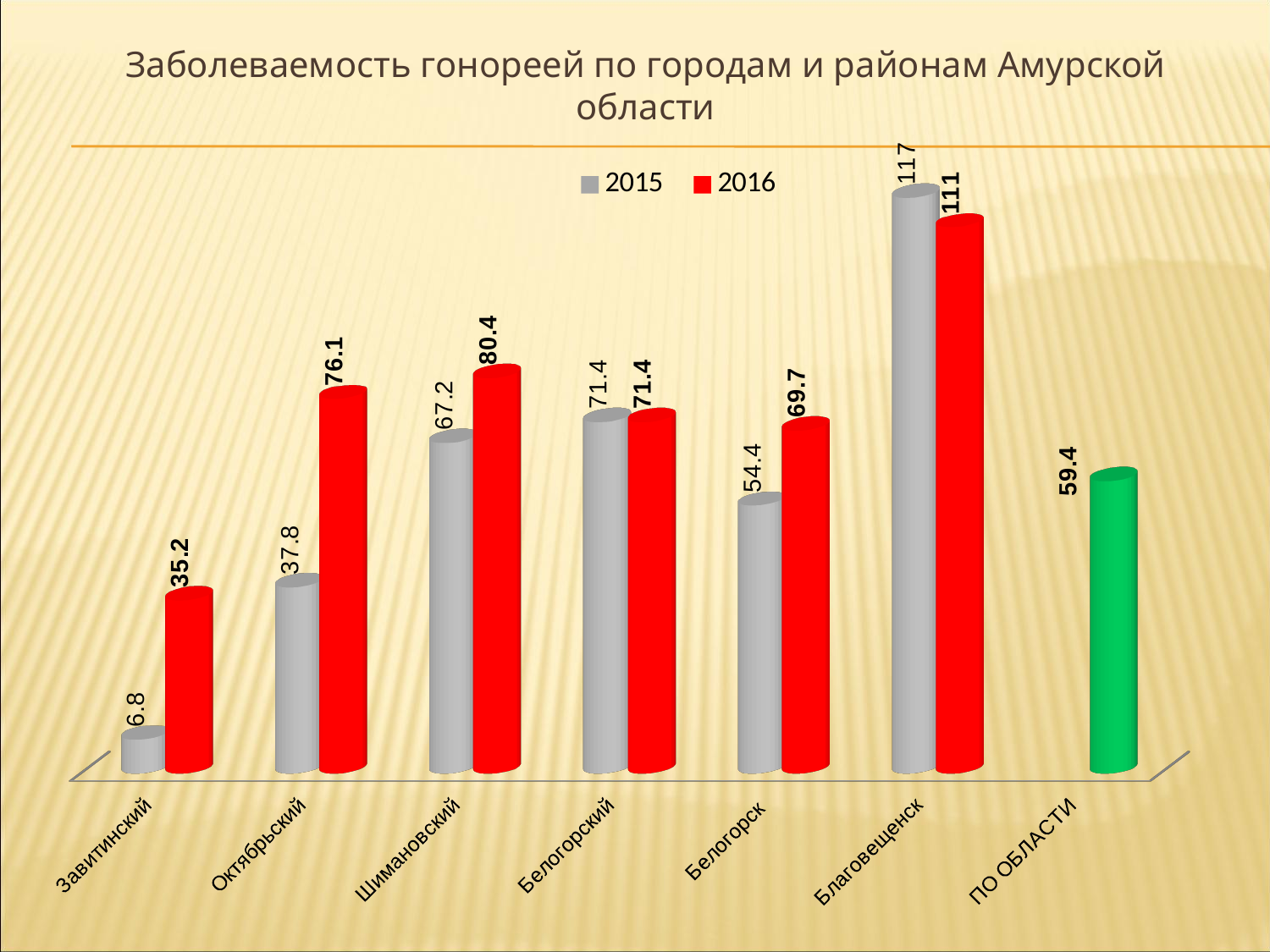
What is the 2015 value for Завитинский? 6.8 Which category has the lowest 2015 value? Завитинский What is the 2016 value for Шимановский? 80.4 What value is shown for ПО ОБЛАСТИ? 59.4 What is the difference between the 2015 and 2016 values for Благовещенск? 6 How many categories are shown on the x axis? 7 What kind of chart is shown on the slide? Bar chart What is the 2015 value for Белогорск? 54.4 What is the 2016 value for Октябрьский? 76.1 How many series does the legend list? 2 Which is larger for Октябрьский, the 2015 value or the 2016 value? 2016 Which category has the highest 2016 value? Благовещенск